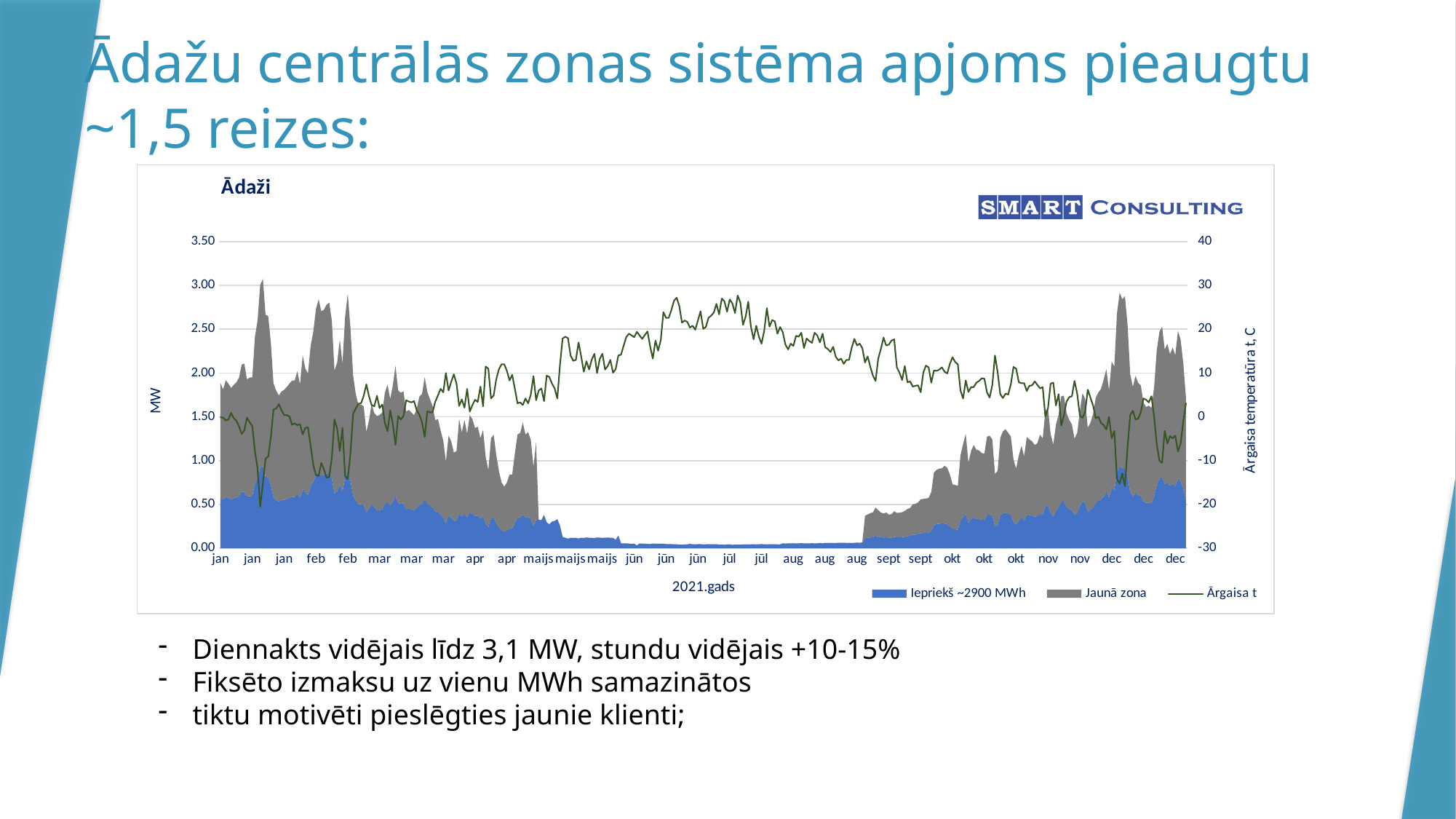
What are the three legend entries of the chart? Iepriekš ~2900 MWh, Jaunā zona, Ārgaisa t Does the outdoor temperature ('Ārgaisa t') rise or fall from July to December? fall Does the 'Iepriekš ~2900 MWh' series rise or fall from February to June? fall Is the value of the 'Iepriekš ~2900 MWh' series in July greater or less than 0.50 MW? less How many series does the legend of the chart list? 3 Does the outdoor temperature ('Ārgaisa t') rise or fall from January to July? rise Is the outdoor temperature ('Ārgaisa t') higher in July or in January? July Is the peak outdoor temperature ('Ārgaisa t') in July greater or less than 20 °C? greater What is the title of the chart? Ādaži What kind of chart is shown on the slide? Area chart with a line Which is higher in January: the peak of the 'Jaunā zona' series or the peak of the 'Iepriekš ~2900 MWh' series? Jaunā zona